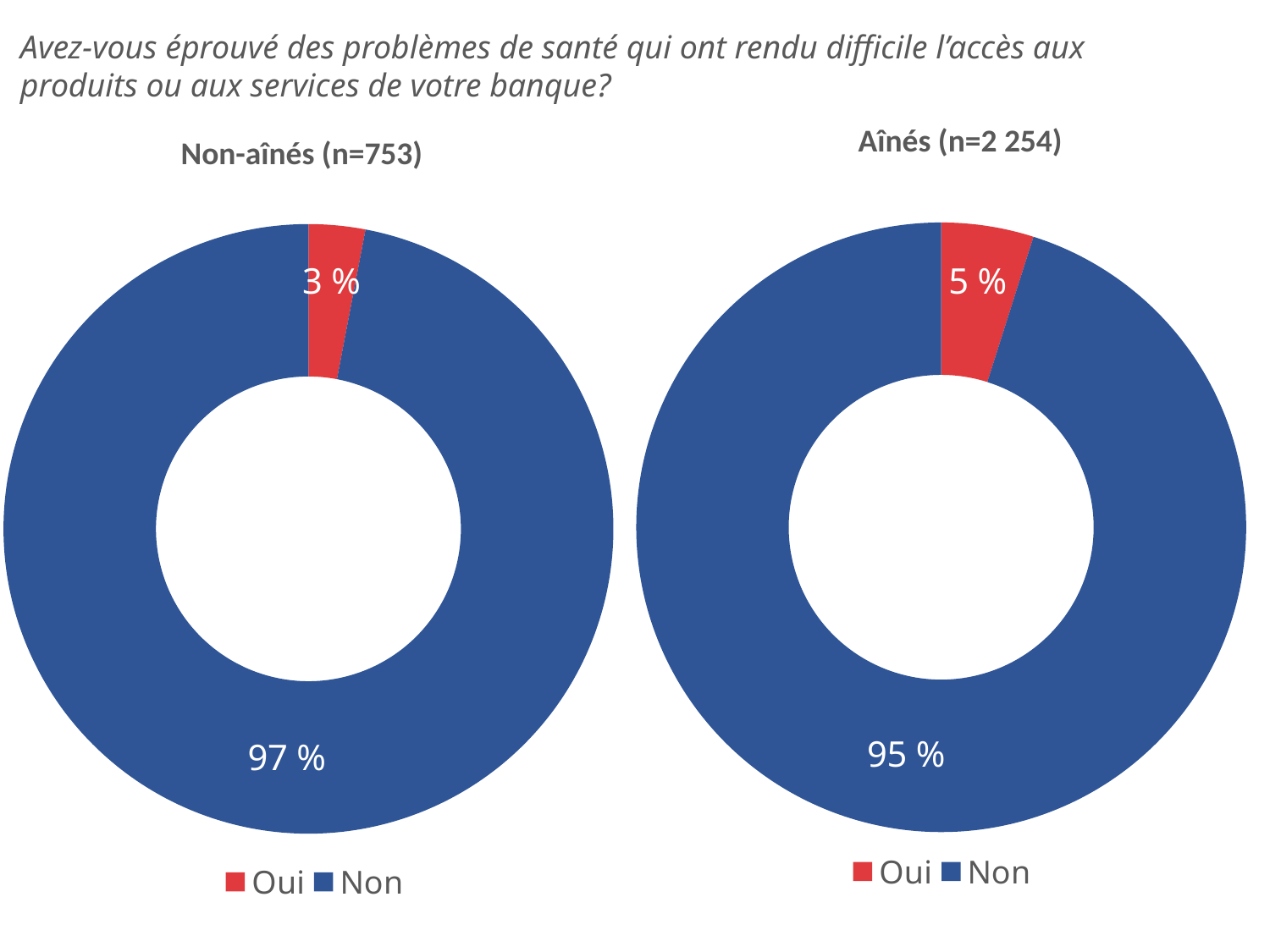
What entries does the legend of the 'Non-aînés (n=753)' chart list? Oui, Non How many categories does the 'Aînés (n=2 254)' chart show? 2 In the 'Non-aînés (n=753)' chart, what percentage answered 'Oui'? 3 % What kind of chart is the 'Non-aînés (n=753)' chart? Doughnut chart Which chart has the larger 'Oui' share, 'Non-aînés (n=753)' or 'Aînés (n=2 254)'? Aînés (n=2 254) In the 'Aînés (n=2 254)' chart, what colour is the 'Oui' slice? Red In the 'Non-aînés (n=753)' chart, what percentage answered 'Non'? 97 % What is the difference between the 'Non' share in the 'Non-aînés (n=753)' chart and the 'Non' share in the 'Aînés (n=2 254)' chart? 2 % In the 'Aînés (n=2 254)' chart, what percentage answered 'Oui'? 5 % In the 'Aînés (n=2 254)' chart, what percentage answered 'Non'? 95 % In the 'Aînés (n=2 254)' chart, which category has the largest share? Non In the 'Non-aînés (n=753)' chart, which category has the smallest share? Oui